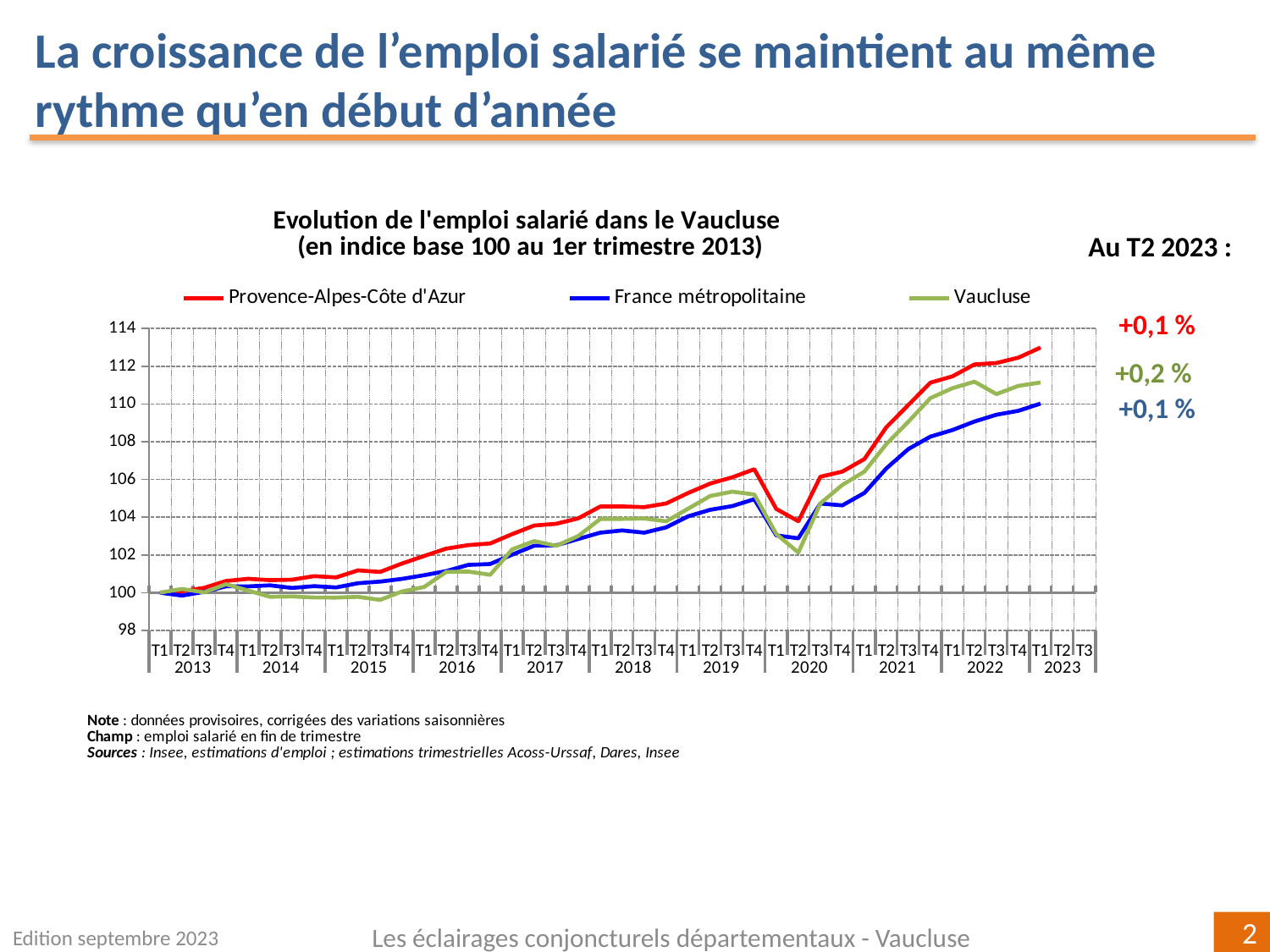
Is the value for Provence-Alpes-Côte d'Azur at T2 2023 greater or less than 112? greater Overall, do the index values rise or fall from 2013 to 2023? rise Is the value for Vaucluse at T2 2020 greater or less than 104? less What change is shown for France métropolitaine at T2 2023? +0,1 % How many series does the legend list? 3 What kind of chart is shown on the slide? line chart What is the title of the chart? Evolution de l'emploi salarié dans le Vaucluse (en indice base 100 au 1er trimestre 2013) What change is shown for Provence-Alpes-Côte d'Azur at T2 2023? +0,1 % Which series has the lowest index value at T2 2023? France métropolitaine Which series are listed in the legend? Provence-Alpes-Côte d'Azur, France métropolitaine, Vaucluse Which series has the highest index value at T2 2023? Provence-Alpes-Côte d'Azur What change is shown for Vaucluse at T2 2023? +0,2 %